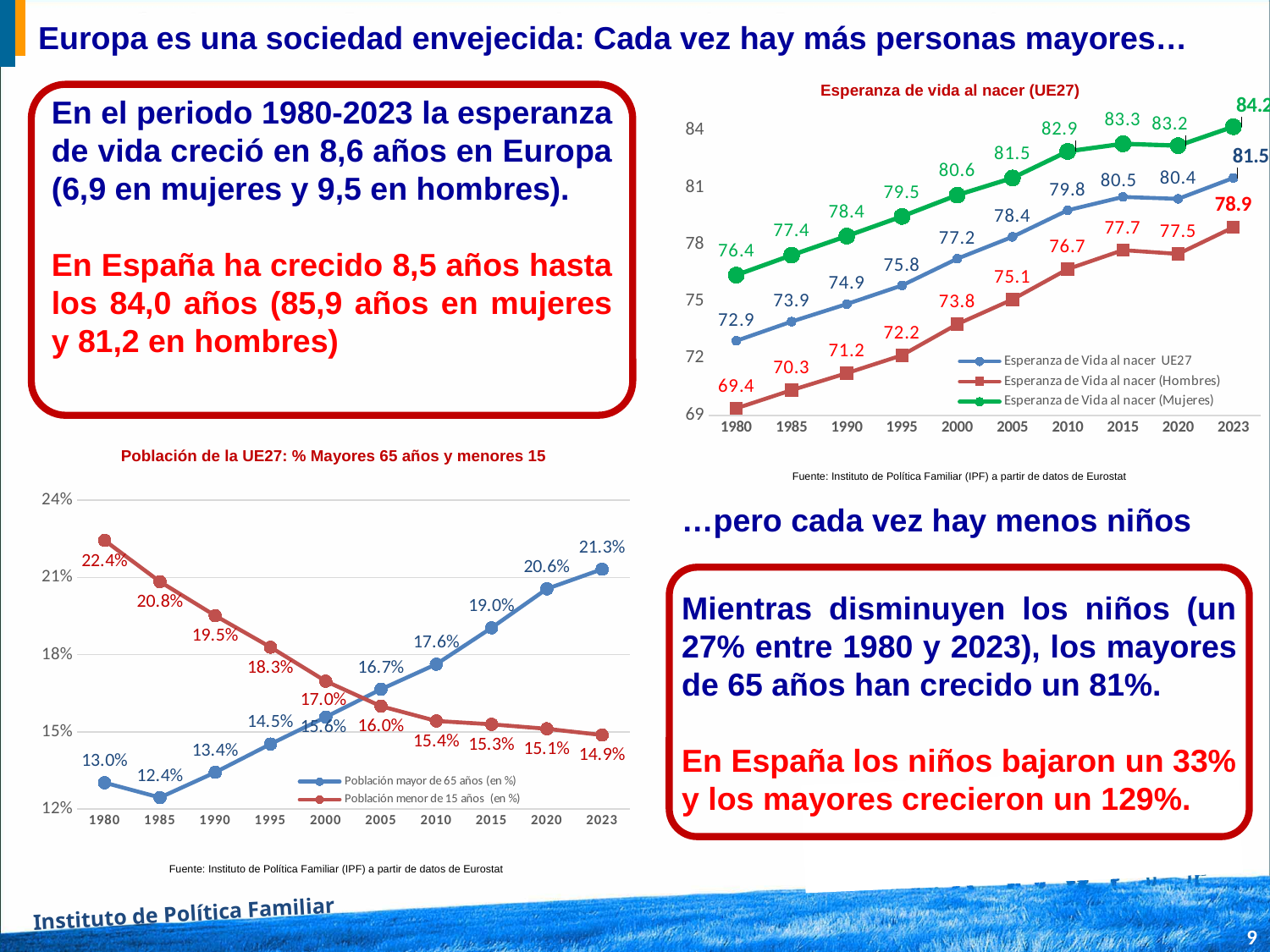
In the chart 'Población de la UE27: % Mayores 65 años y menores 15', how many years are shown on the x axis? 10 What kind of chart is 'Esperanza de vida al nacer (UE27)'? Line chart In the chart 'Población de la UE27: % Mayores 65 años y menores 15', what is the difference between the 2023 and 1980 values for Población mayor de 65 años? 8.3% In the chart 'Población de la UE27: % Mayores 65 años y menores 15', which is larger in 2000: Población mayor de 65 años or Población menor de 15 años? Población menor de 15 años In the chart 'Esperanza de vida al nacer (UE27)', what is the difference between the Mujeres and Hombres values in 2023? 5.3 In the chart 'Esperanza de vida al nacer (UE27)', what is the value for Esperanza de Vida al nacer (Hombres) in 1980? 69.4 In the chart 'Población de la UE27: % Mayores 65 años y menores 15', does the Población menor de 15 años series rise or fall from 1980 to 2023? Fall In the chart 'Población de la UE27: % Mayores 65 años y menores 15', what is the value for Población menor de 15 años in 1980? 22.4% In the chart 'Población de la UE27: % Mayores 65 años y menores 15', what is the value for Población mayor de 65 años in 2023? 21.3% In the chart 'Esperanza de vida al nacer (UE27)', what is the value for Esperanza de Vida al nacer (Mujeres) in 2023? 84.2 In the chart 'Esperanza de vida al nacer (UE27)', how many series does the legend list? 3 In the chart 'Esperanza de vida al nacer (UE27)', in which year is the Esperanza de Vida al nacer UE27 series lowest? 1980